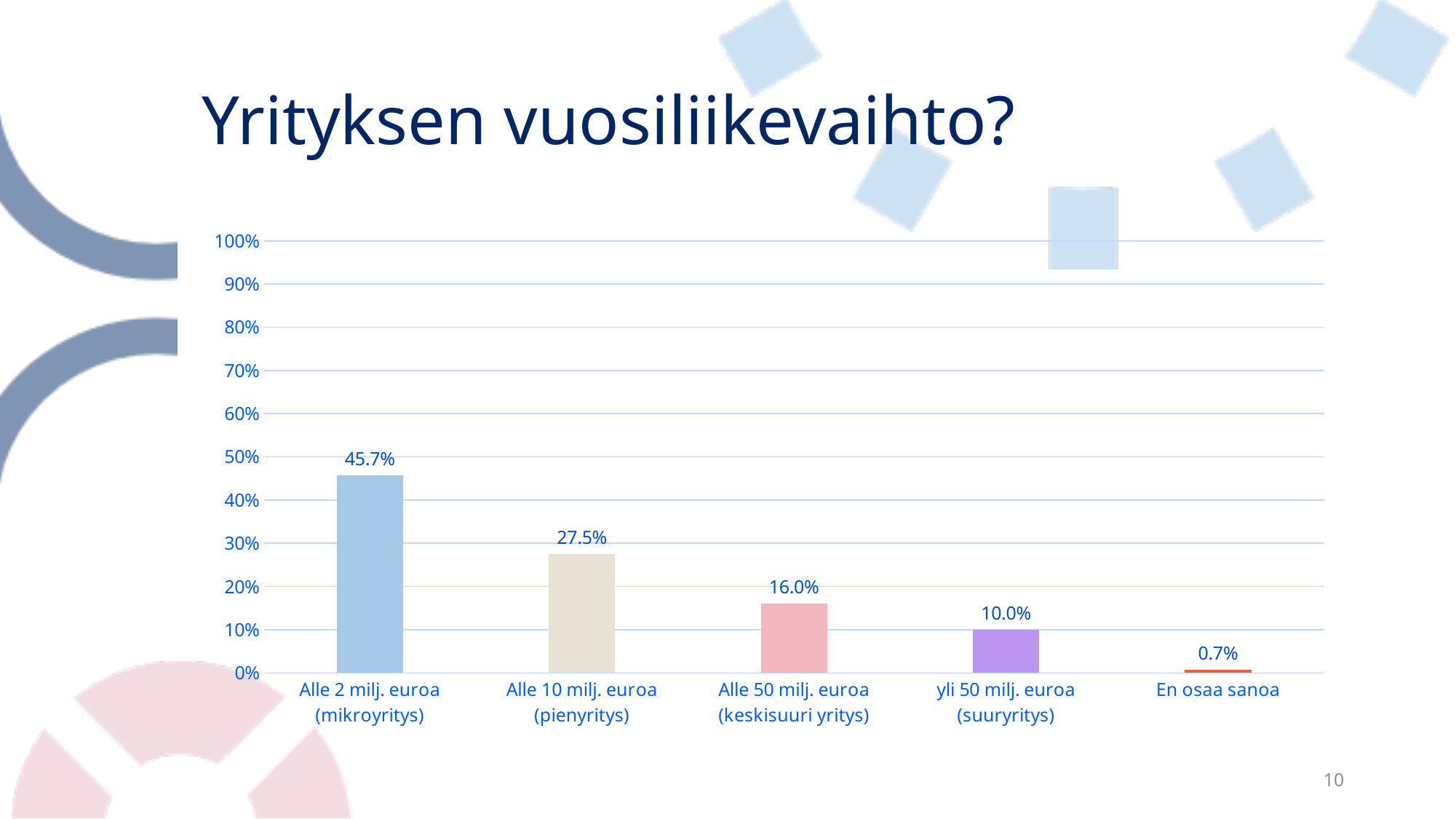
Which category has the highest value? Alle 2 milj. euroa (mikroyritys) What is the value for Alle 2 milj. euroa (mikroyritys)? 45.7% What is the title of the slide? Yrityksen vuosiliikevaihto? Which category has the lowest value? En osaa sanoa What is the value for yli 50 milj. euroa (suuryritys)? 10.0% What is the value for Alle 50 milj. euroa (keskisuuri yritys)? 16.0% What kind of chart is shown on the slide? Bar chart Which is larger, the value for Alle 50 milj. euroa (keskisuuri yritys) or yli 50 milj. euroa (suuryritys)? Alle 50 milj. euroa (keskisuuri yritys) What is the value for En osaa sanoa? 0.7% How many categories are shown on the x axis? 5 What is the value for Alle 10 milj. euroa (pienyritys)? 27.5% What is the difference between the values for Alle 2 milj. euroa (mikroyritys) and Alle 10 milj. euroa (pienyritys)? 18.2%